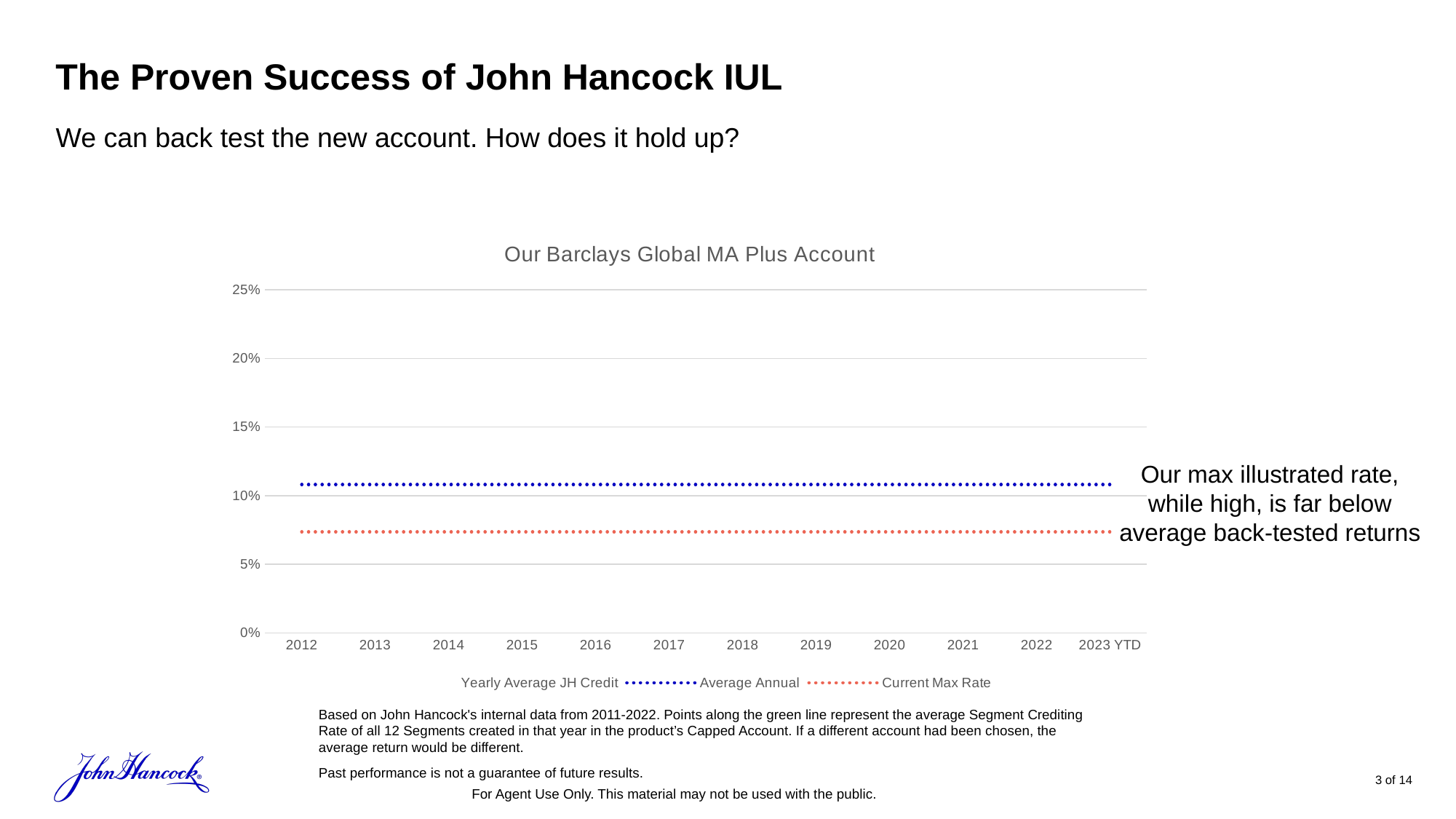
What colour is the Current Max Rate line in the chart? red Is the value of the Average Annual line greater or less than 10%? greater Is the value of the Current Max Rate line greater or less than 10%? less What is the title of the chart? Our Barclays Global MA Plus Account Which line is higher on the chart, Average Annual or Current Max Rate? Average Annual How many years are shown along the x axis of the chart? 12 What kind of chart is shown on the slide? line chart Is the value of the Average Annual line greater or less than 15%? less How many series does the chart legend list? 3 What is the first year shown on the x axis of the chart? 2012 Does the Average Annual line rise, fall, or stay flat from 2012 to 2023 YTD? stays flat